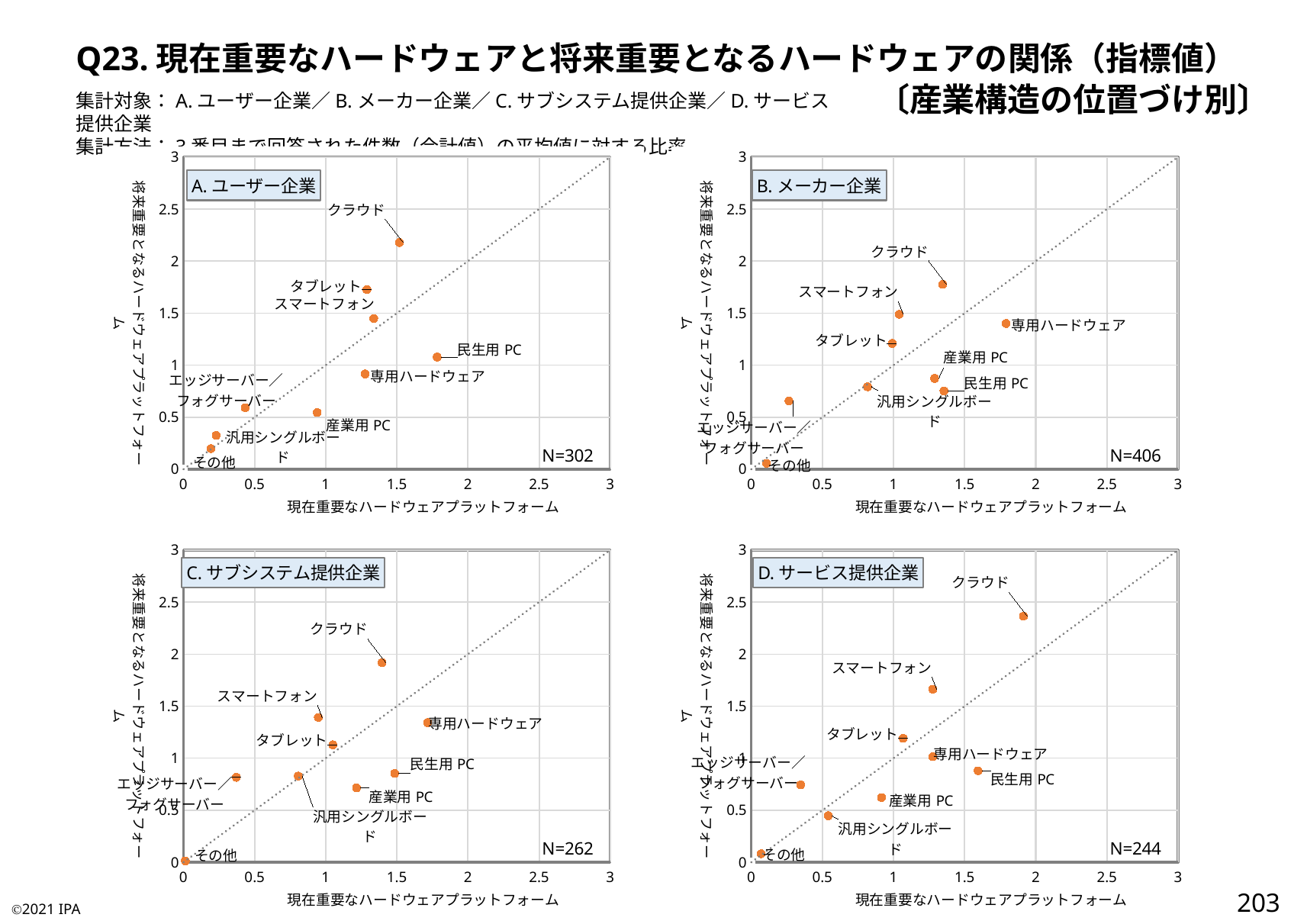
In the chart titled C. サブシステム提供企業, which hardware platform has the lowest value on the vertical axis? その他 What is the N value shown in the chart titled B. メーカー企業? N=406 In the chart titled C. サブシステム提供企業, which has the larger vertical-axis value, スマートフォン or タブレット? スマートフォン In the chart titled B. メーカー企業, is the vertical-axis value for クラウド greater or less than 2? less What kind of chart is used for the four panels on this slide? scatter chart In the chart titled A. ユーザー企業, is the vertical-axis value for クラウド greater or less than 2? greater In the chart titled D. サービス提供企業, is the vertical-axis value for クラウド greater or less than 2? greater In the chart titled D. サービス提供企業, which has the larger horizontal-axis value, 民生用 PC or 専用ハードウェア? 民生用 PC In the chart titled A. ユーザー企業, which hardware platform has the highest value on the vertical axis (将来重要となるハードウェアプラットフォーム)? クラウド In the chart titled B. メーカー企業, which hardware platform has the highest value on the horizontal axis (現在重要なハードウェアプラットフォーム)? 専用ハードウェア In the chart titled A. ユーザー企業, how many data points are plotted? 9